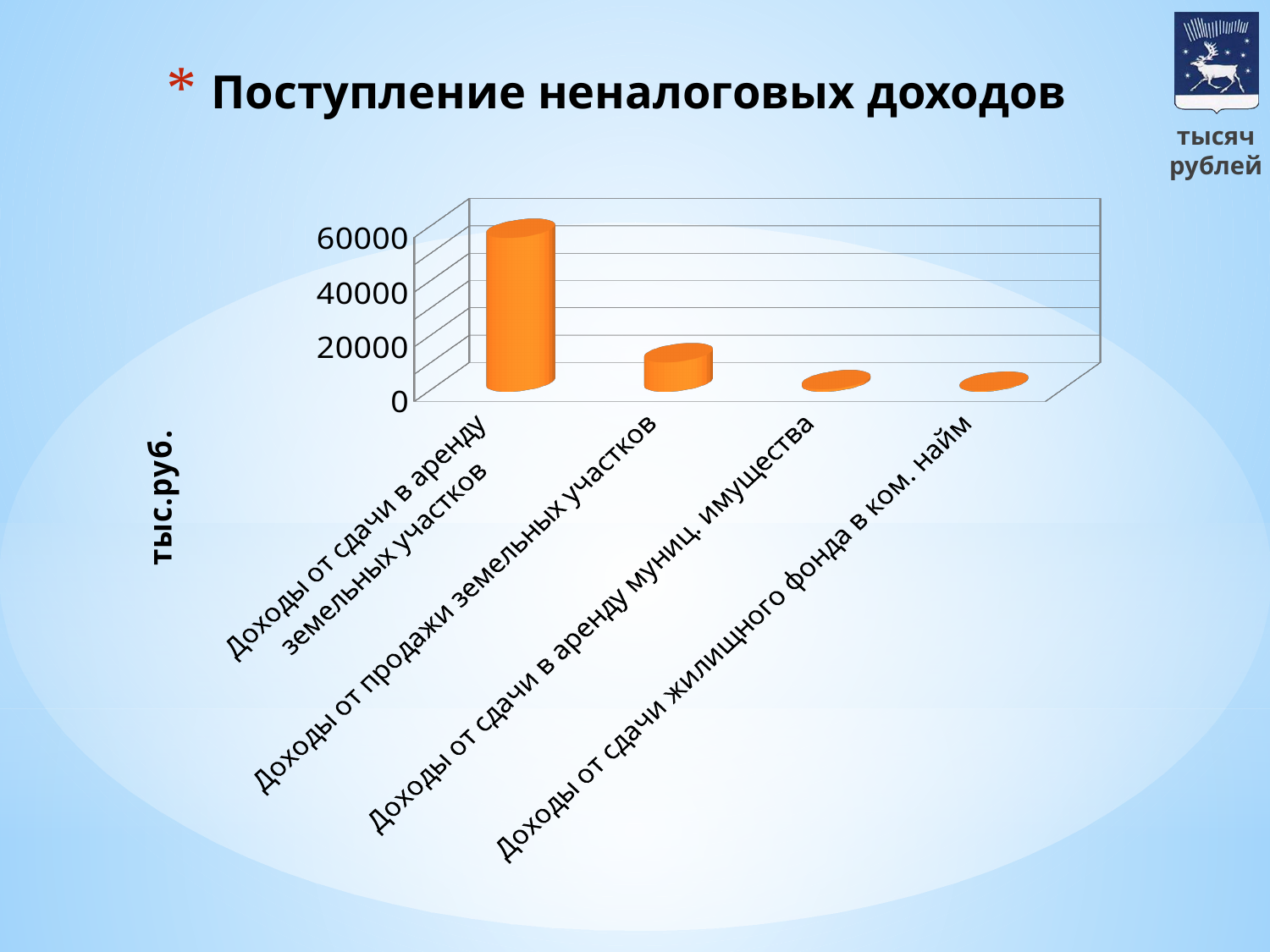
Is the value for "Доходы от сдачи жилищного фонда в ком. найм" greater or less than 20000? less What unit label is shown on the vertical axis of the chart? тыс.руб. What kind of chart is shown on the slide? bar chart What is the title of the slide containing the chart? Поступление неналоговых доходов Which is larger: the value for "Доходы от сдачи в аренду земельных участков" or for "Доходы от продажи земельных участков"? Доходы от сдачи в аренду земельных участков Which is larger: the value for "Доходы от продажи земельных участков" or for "Доходы от сдачи в аренду муниц. имущества"? Доходы от продажи земельных участков Is the value for "Доходы от сдачи в аренду муниц. имущества" greater or less than 20000? less Is the value for "Доходы от сдачи в аренду земельных участков" greater or less than 40000? greater How many categories are plotted on the chart? 4 Which category has the highest value on the chart? Доходы от сдачи в аренду земельных участков Do the values rise or fall moving from left to right along the x axis? fall